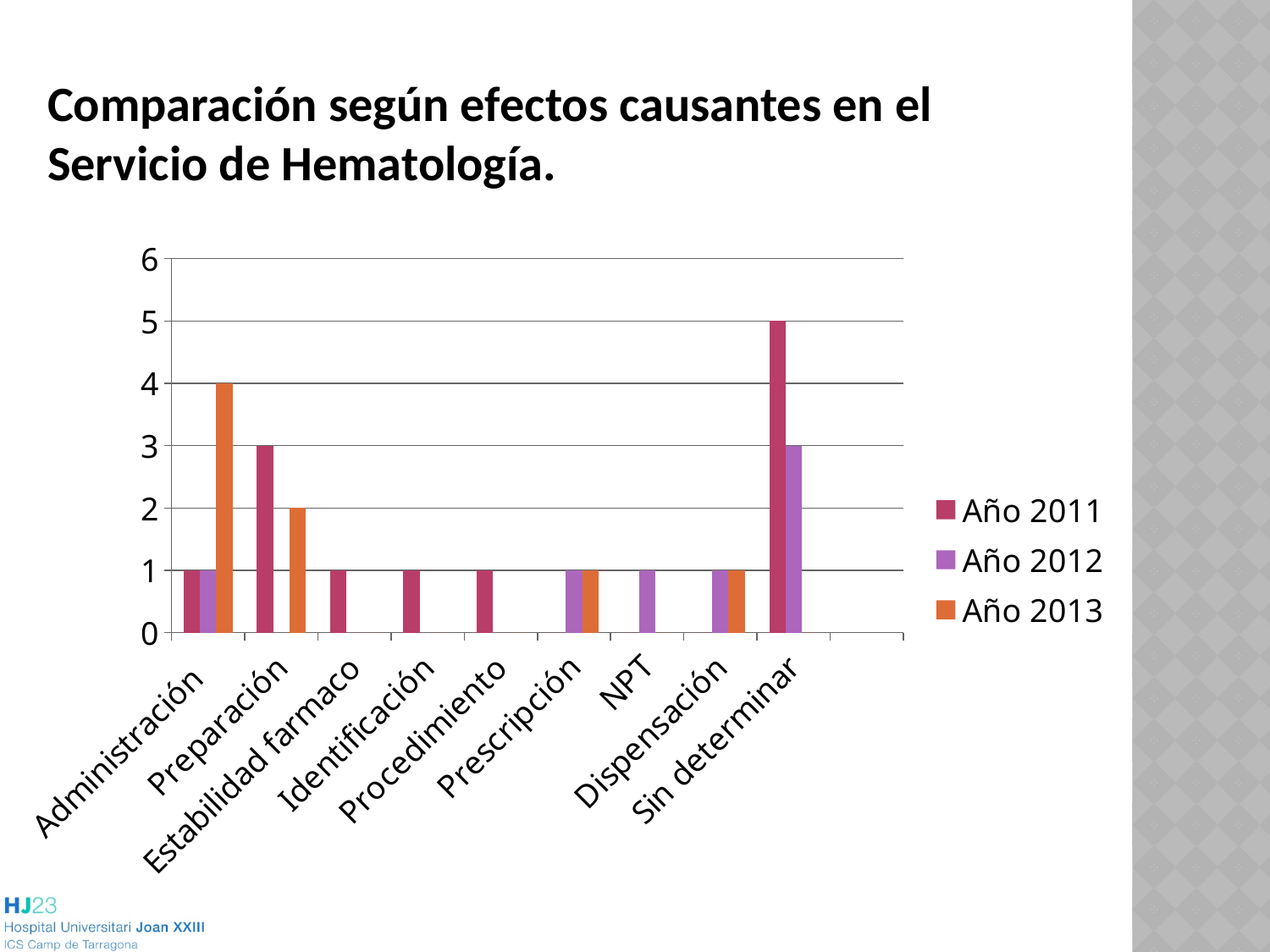
How many categories are shown on the x axis? 9 Which category has the highest value for Año 2011? Sin determinar Which category has the highest value for Año 2013? Administración What is the value for Año 2012 in the Sin determinar category? 3 What type of chart is shown on the slide? bar chart Which series is shown in orange in the legend? Año 2013 How many series does the legend list? 3 What is the difference between the Año 2011 and Año 2012 values in the Sin determinar category? 2 What is the value for Año 2011 in the Sin determinar category? 5 In the Preparación category, which is larger: the Año 2011 value or the Año 2013 value? Año 2011 What is the value for Año 2013 in the Administración category? 4 What is the value for Año 2011 in the Preparación category? 3